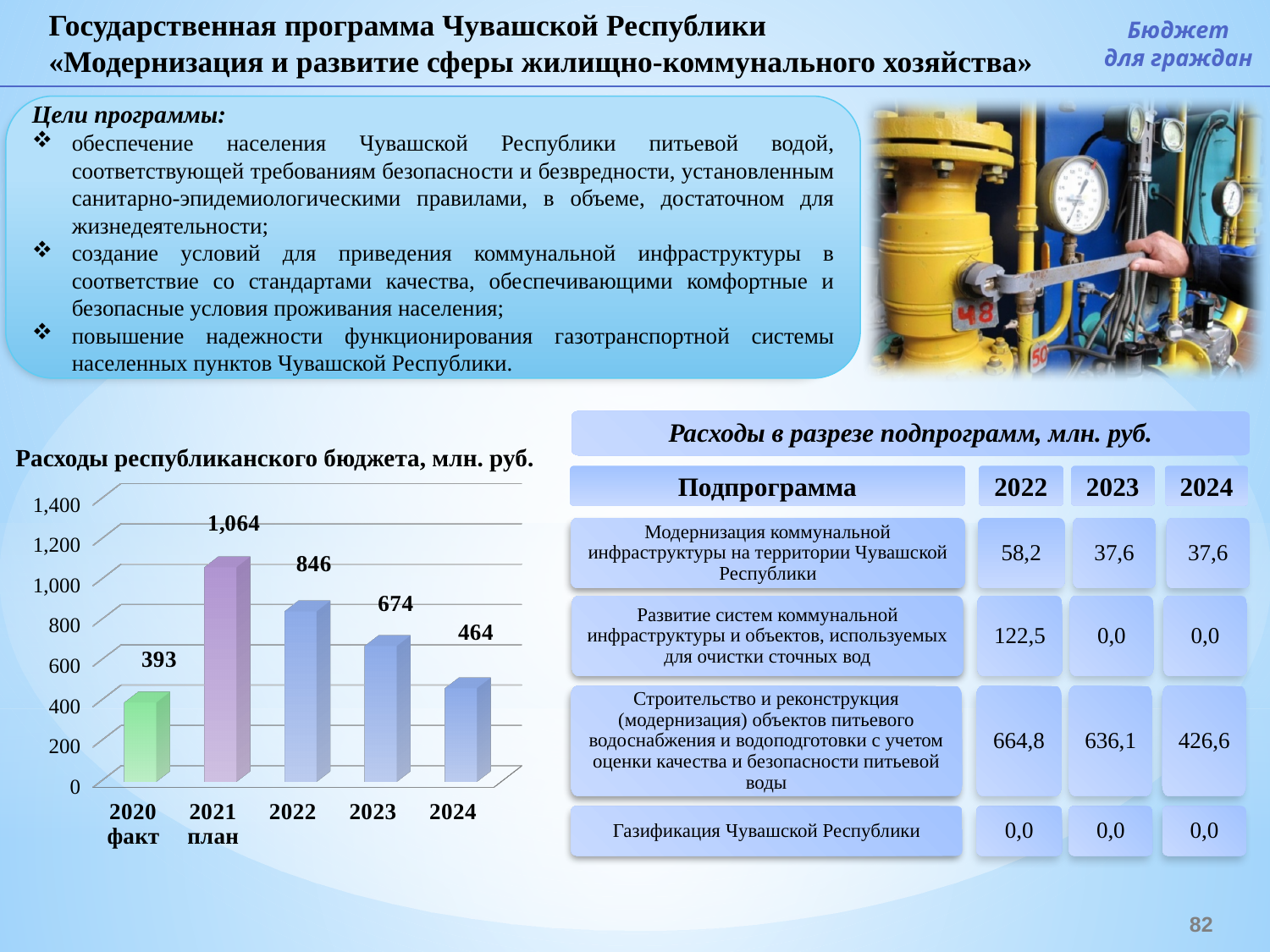
Which year has the highest value in the chart 'Расходы республиканского бюджета, млн. руб.'? 2021 Which year has the lowest value in the chart 'Расходы республиканского бюджета, млн. руб.'? 2020 What is the value for 2023 in the chart 'Расходы республиканского бюджета, млн. руб.'? 674 What is the value for 2021 in the chart 'Расходы республиканского бюджета, млн. руб.'? 1,064 What is the difference between the 2023 and 2024 values in the chart 'Расходы республиканского бюджета, млн. руб.'? 210 How many bars are shown in the chart 'Расходы республиканского бюджета, млн. руб.'? 5 What is the difference between the 2021 and 2022 values in the chart 'Расходы республиканского бюджета, млн. руб.'? 218 In the chart 'Расходы республиканского бюджета, млн. руб.', is the value for 2022 greater or less than 800? greater In the chart 'Расходы республиканского бюджета, млн. руб.', do the values rise or fall from 2021 to 2024? fall What type of chart is 'Расходы республиканского бюджета, млн. руб.'? bar chart In the chart 'Расходы республиканского бюджета, млн. руб.', which is larger: the value for 2020 or the value for 2024? 2024 What is the value for 2020 in the chart 'Расходы республиканского бюджета, млн. руб.'? 393